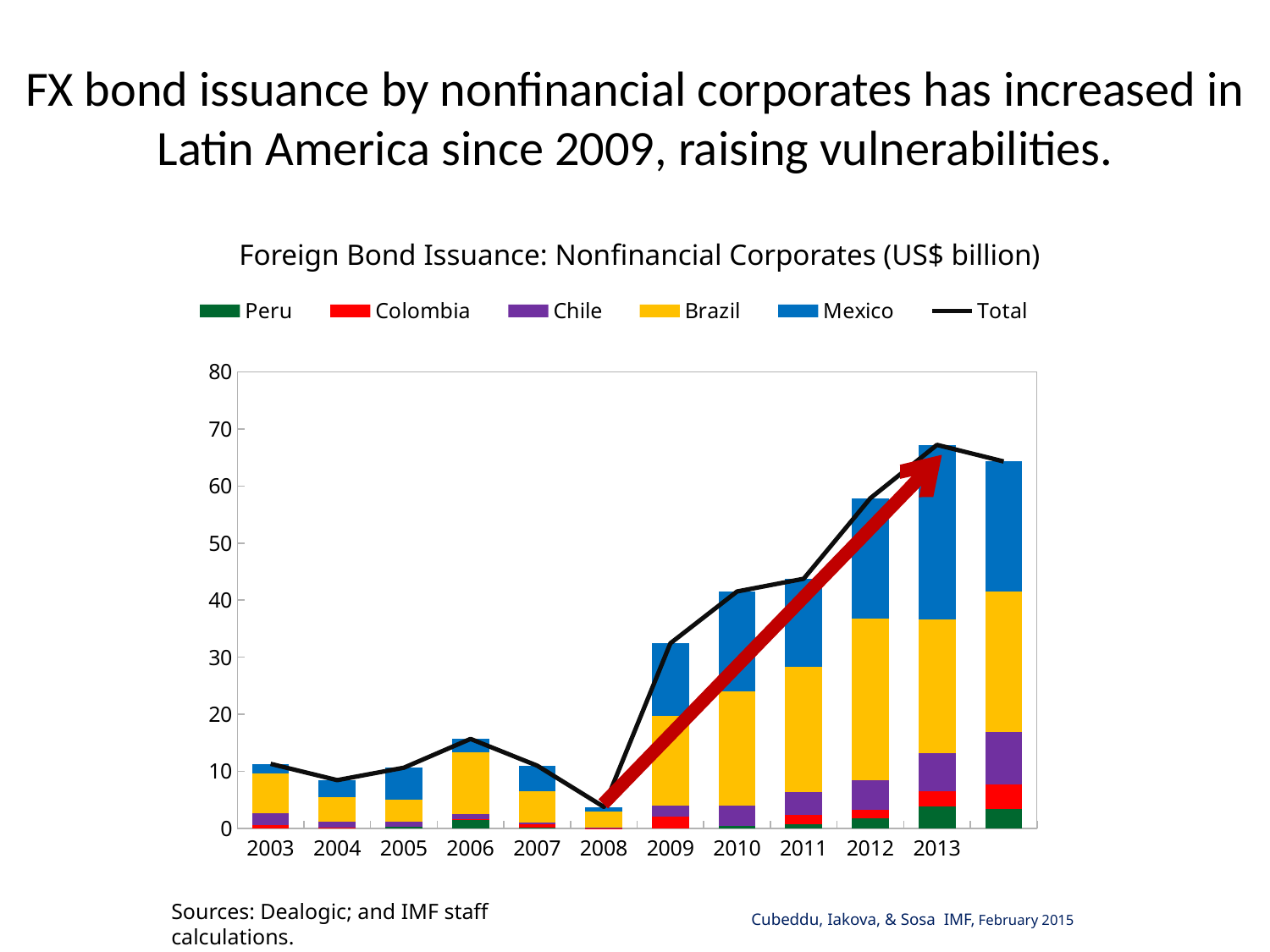
Which labeled year has the highest total foreign bond issuance? 2013 Which year has a larger total, 2008 or 2009? 2009 Which labeled year has the lowest total foreign bond issuance? 2008 What is the title of the chart? Foreign Bond Issuance: Nonfinancial Corporates (US$ billion) What kind of chart is shown on the slide? Stacked bar chart with a line Is the total value for 2012 greater or less than 50? greater How many series does the legend list? 6 Is the total value for 2013 greater or less than 60? greater Is the total value for 2006 greater or less than 10? greater Do the total values rise or fall from 2009 to 2013? rise